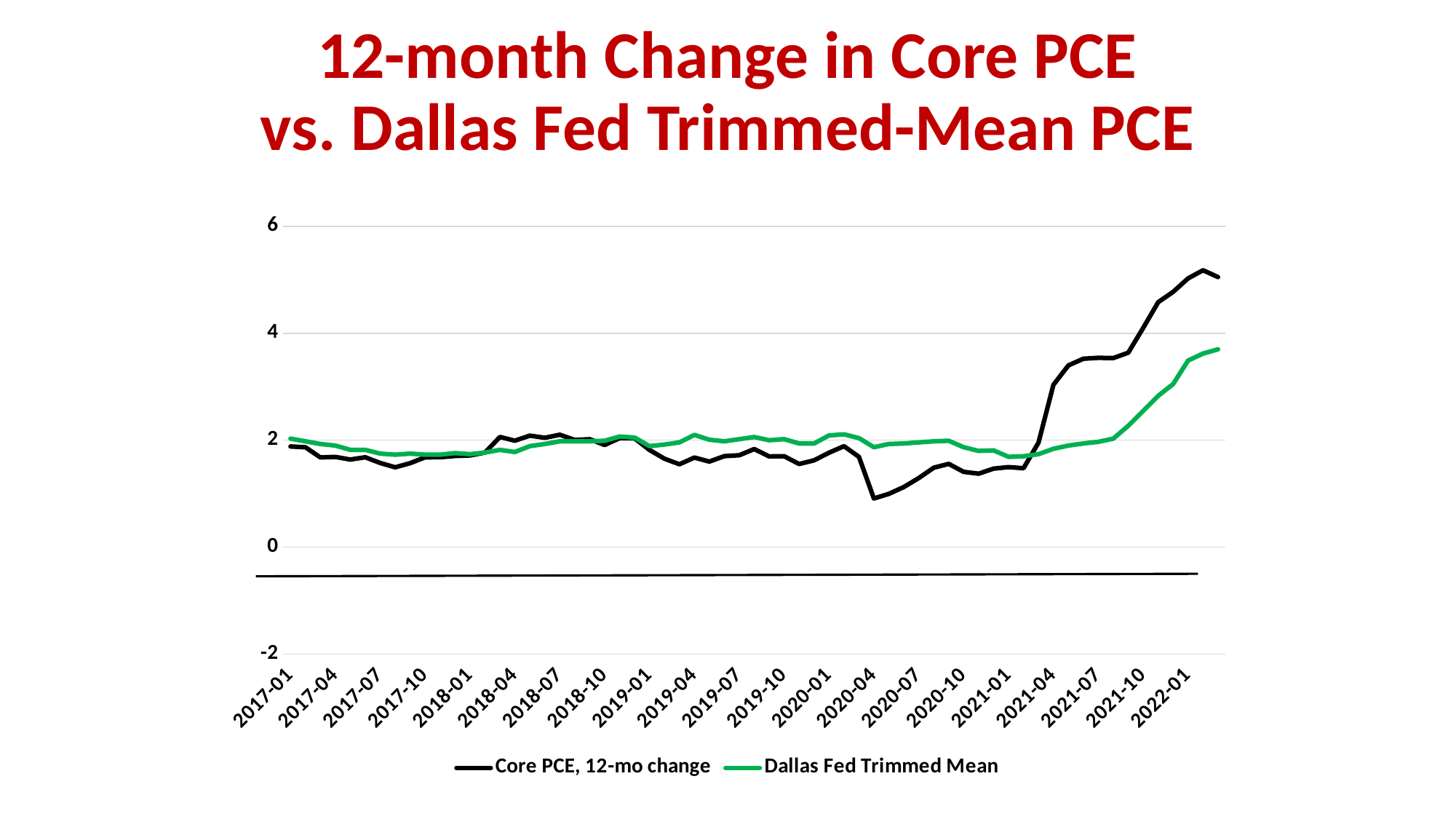
Does the Core PCE, 12-mo change line rise or fall between 2021-01 and 2022-01? Rise Is the value of Core PCE, 12-mo change at 2022-01 greater or less than 4? greater How many series does the legend list? 2 What colour is the Dallas Fed Trimmed Mean line? Green At 2022-01, which series has the higher value: Core PCE, 12-mo change or Dallas Fed Trimmed Mean? Core PCE, 12-mo change Which series reaches the highest value anywhere on the chart? Core PCE, 12-mo change Is the value of Core PCE, 12-mo change at 2021-07 greater or less than 2? greater What is the title of the chart? 12-month Change in Core PCE vs. Dallas Fed Trimmed-Mean PCE At 2020-07, which series has the higher value: Core PCE, 12-mo change or Dallas Fed Trimmed Mean? Dallas Fed Trimmed Mean Is the value of Dallas Fed Trimmed Mean at 2022-01 greater or less than 4? less What kind of chart is shown on the slide? Line chart